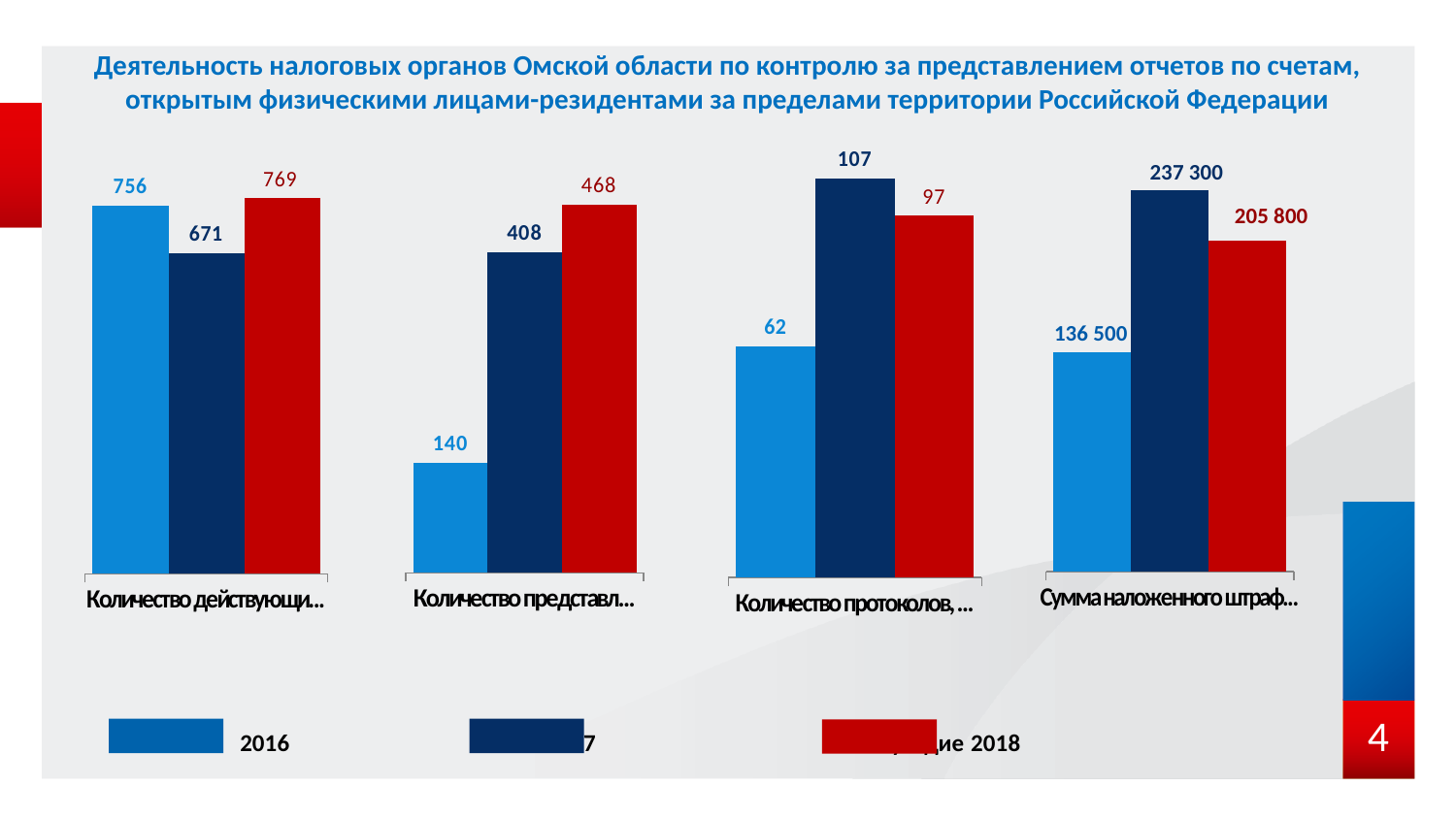
How many bars does each of the charts on the slide contain? 3 In the leftmost chart ("Количество действующи..."), what is the difference between the red bar and the dark blue bar? 98 In the rightmost chart ("Сумма наложенного штраф..."), how much larger is the dark blue bar than the red bar? 31 500 In the second chart from the left ("Количество представл..."), what is the value of the red bar? 468 In the third chart from the left ("Количество протоколов, ..."), which is larger: the dark blue bar or the red bar? The dark blue bar (107) In the second chart from the left ("Количество представл..."), which bar has the highest value? The red bar (468) What type of chart is used on this slide? Bar chart In the third chart from the left ("Количество протоколов, ..."), which bar has the lowest value? The light blue 2016 bar (62) In the third chart from the left ("Количество протоколов, ..."), what is the value of the dark blue bar? 107 In the leftmost chart ("Количество действующи..."), what is the value of the light blue 2016 bar? 756 How many separate charts are shown on the slide? 4 In the rightmost chart ("Сумма наложенного штраф..."), what is the value of the light blue 2016 bar? 136 500